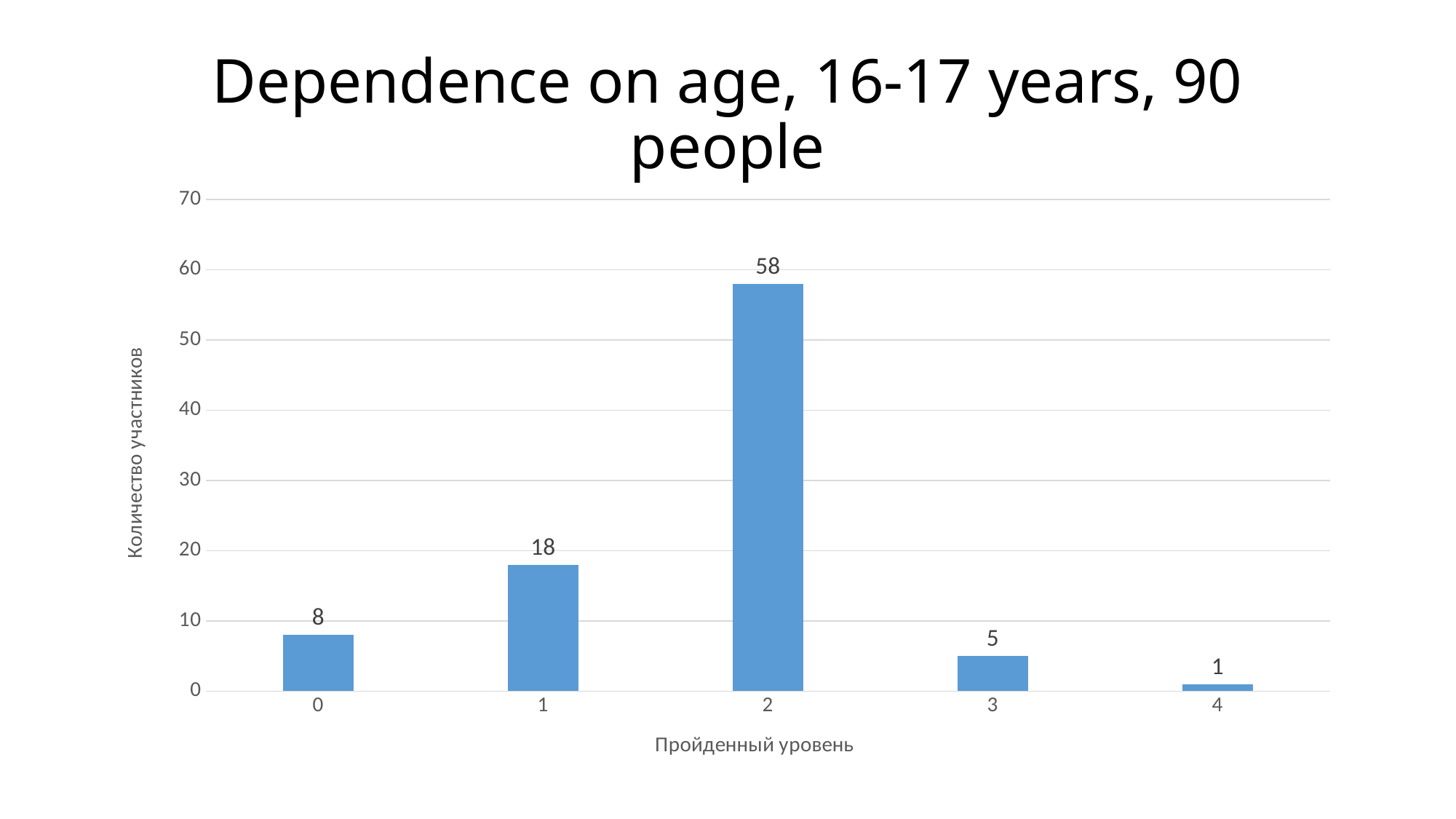
Is the value for level 2 greater or less than 50? greater What is the value for level 0? 8 Which level has the highest number of participants? 2 Which level has the lowest number of participants? 4 What is the title of the chart? Dependence on age, 16-17 years, 90 people What is the difference between the values for level 2 and level 1? 40 What is the difference between the values for level 0 and level 3? 3 What is the value for level 2? 58 What is the value for level 4? 1 How many levels (categories) are shown on the x axis? 5 What kind of chart is shown on the slide? bar chart Which is larger, the value for level 1 or the value for level 3? level 1